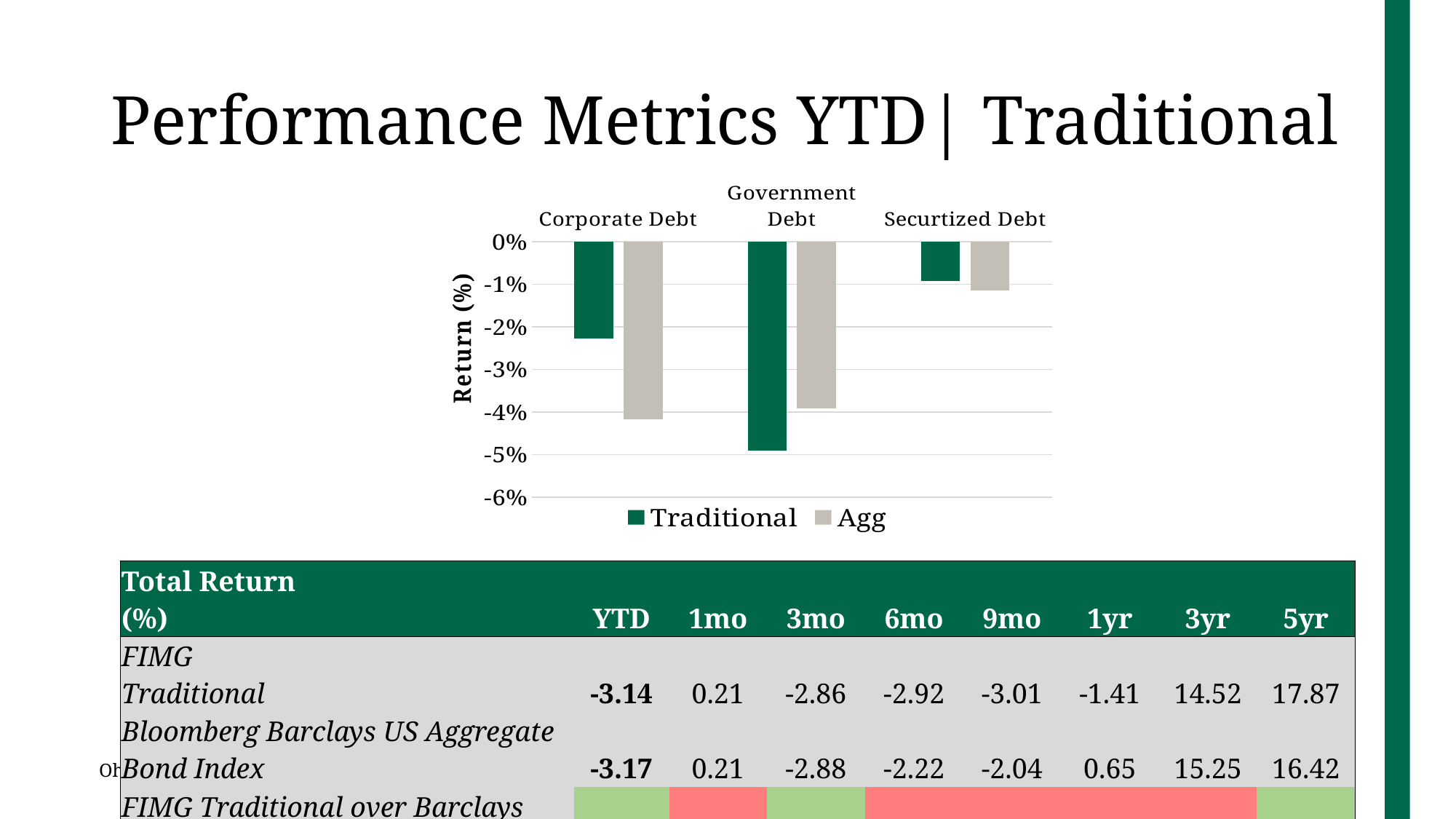
For which category is the Agg bar the highest (least negative)? Securtized Debt What are the two series named in the chart's legend? Traditional and Agg For Government Debt, which series has the lower (more negative) return, Traditional or Agg? Traditional What kind of chart is shown on the slide? bar chart For Corporate Debt, which series has the higher (less negative) return, Traditional or Agg? Traditional How many series does the chart's legend list? 2 Is the Traditional return for Government Debt greater or less than -4%? less For which category is the Traditional bar the highest (least negative)? Securtized Debt How many debt categories are shown on the chart's x axis? 3 For which category is the Traditional bar the lowest (most negative)? Government Debt What is the title of the chart's vertical axis? Return (%)